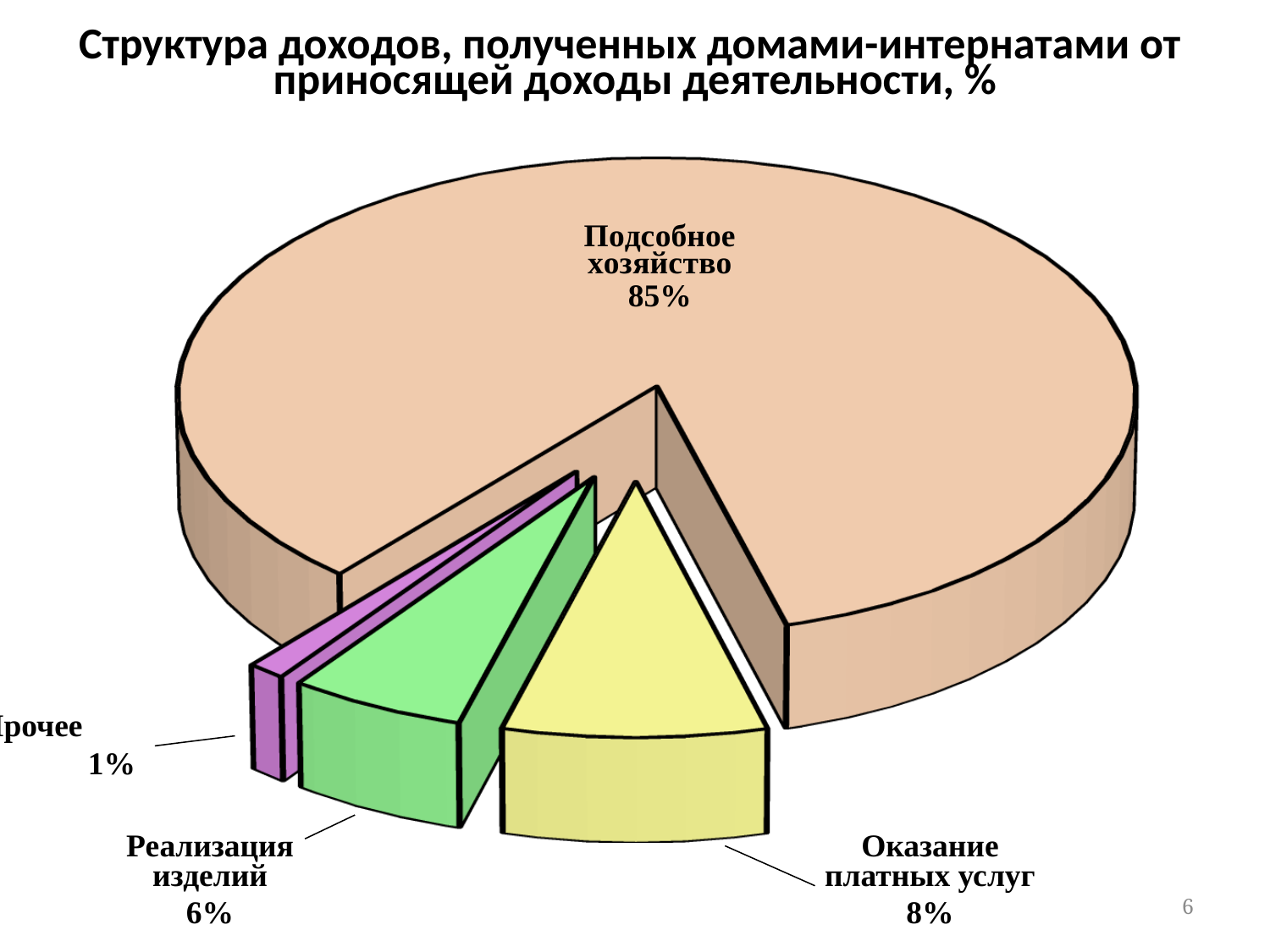
What is the value shown for Оказание платных услуг? 8% What type of chart is shown on the slide? Pie chart What is the difference in percentage points between Подсобное хозяйство and Оказание платных услуг? 77 What is the title of the chart? Структура доходов, полученных домами-интернатами от приносящей доходы деятельности, % What share of the pie does Подсобное хозяйство account for? 85% What is the difference in percentage points between Оказание платных услуг and Реализация изделий? 2 Which category has the largest share of the pie? Подсобное хозяйство What is the value shown for Прочее? 1% Which is larger, the share for Реализация изделий or the share for Прочее? Реализация изделий What is the value shown for Реализация изделий? 6% How many slices does the pie chart have? 4 Which category has the smallest share of the pie? Прочее